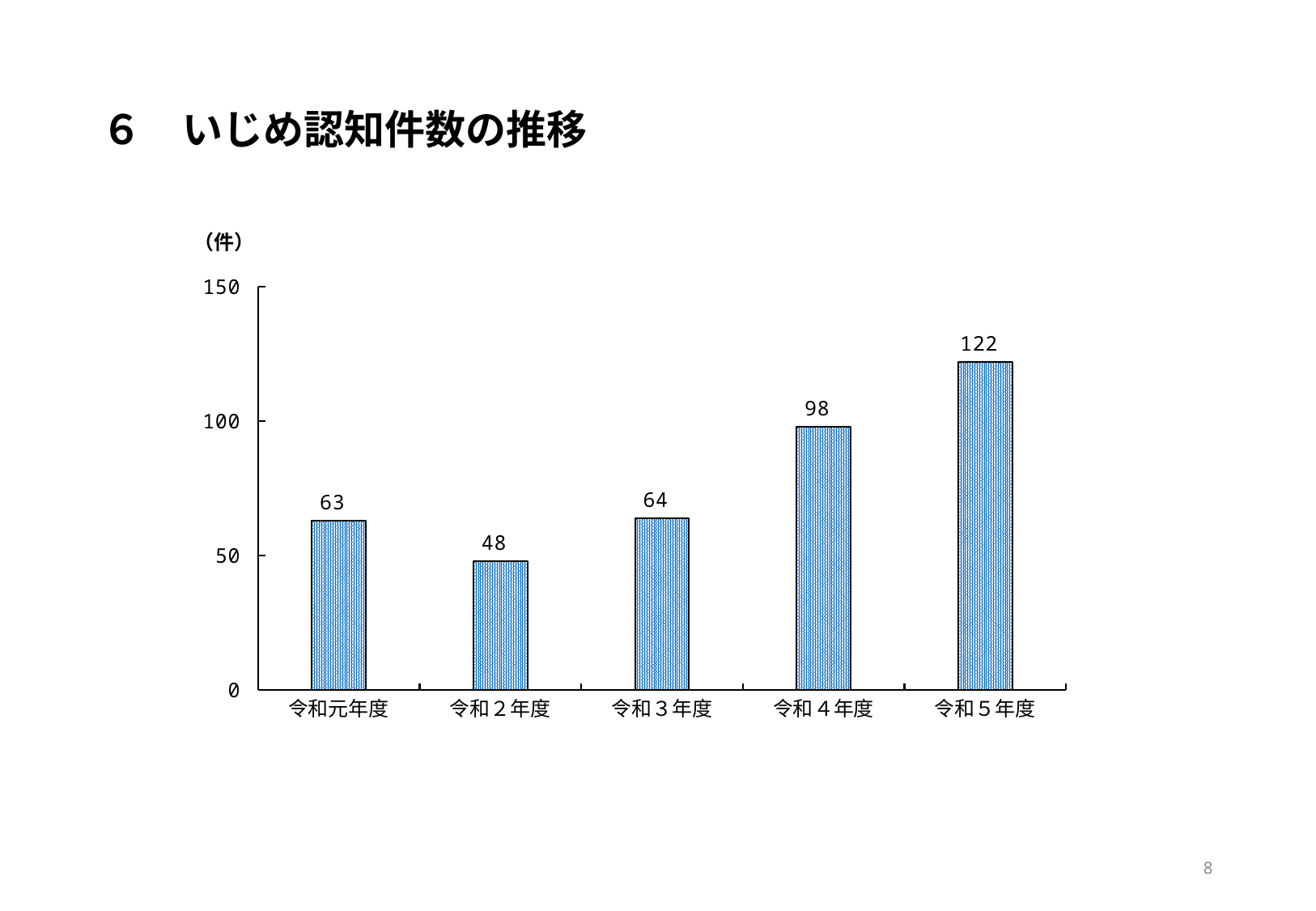
What is the value for 令和２年度? 48 Is the value for 令和４年度 greater or less than 100? less What kind of chart is shown on the slide? bar chart What is the value for 令和５年度? 122 What is the difference between the values for 令和５年度 and 令和４年度? 24 How many years are shown on the x axis? 5 Which is larger, the value for 令和３年度 or 令和４年度? 令和４年度 What unit is shown above the y axis? （件） What is the value for 令和元年度? 63 Which year has the lowest value? 令和２年度 Do the values rise or fall from 令和２年度 to 令和５年度? rise Which year has the highest value? 令和５年度